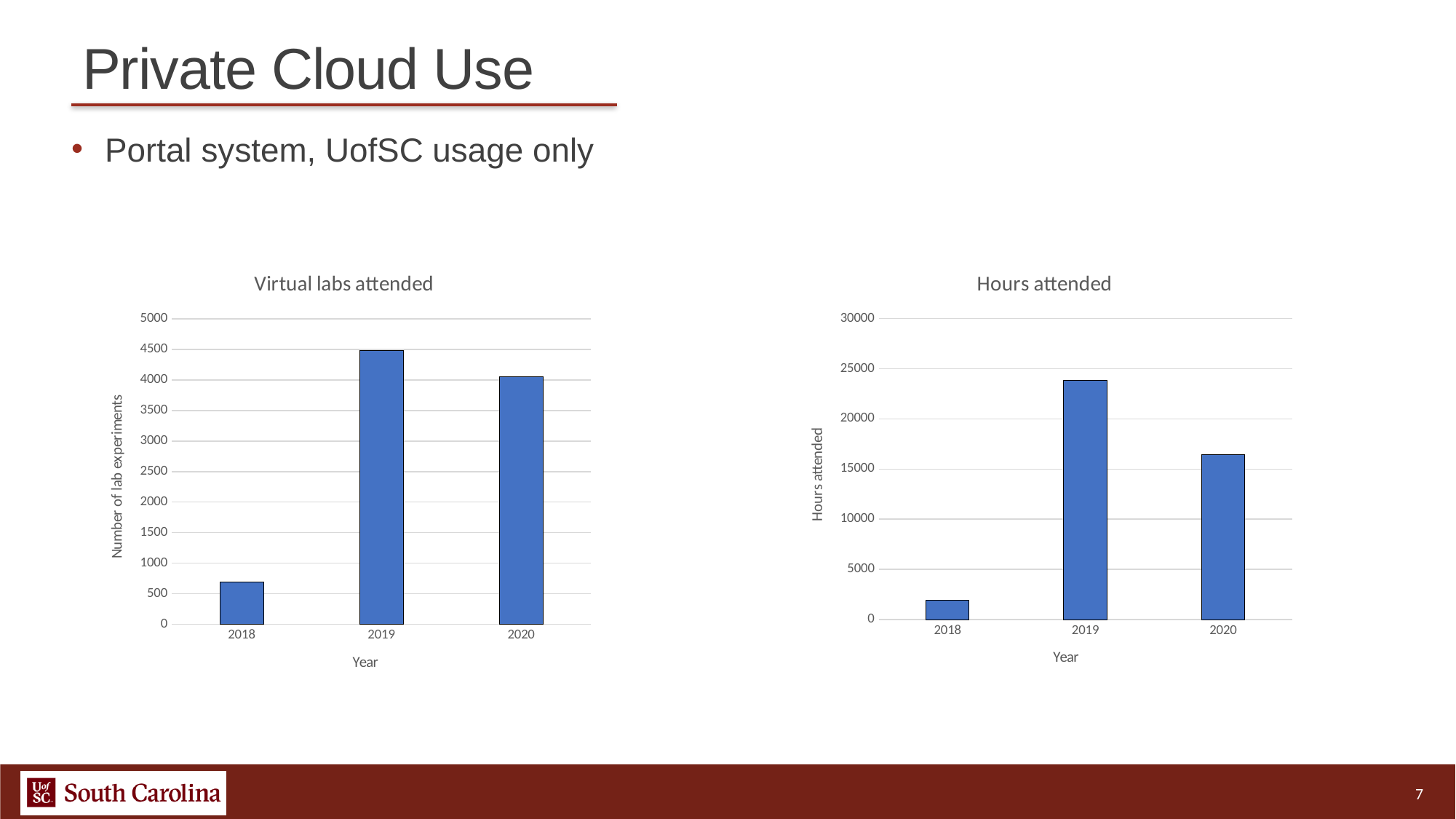
In the 'Virtual labs attended' chart, what is the label on the y axis? Number of lab experiments In the 'Hours attended' chart, does the value rise or fall from 2019 to 2020? fall In the 'Hours attended' chart, which year has the highest value? 2019 In the 'Virtual labs attended' chart, is the value for 2018 greater or less than 1000? less In the 'Virtual labs attended' chart, which year has the highest value? 2019 In the 'Virtual labs attended' chart, which year has the lowest value? 2018 In the 'Virtual labs attended' chart, how many years are plotted on the x axis? 3 In the 'Hours attended' chart, is the value for 2020 greater or less than 15000? greater In the 'Virtual labs attended' chart, is the value for 2020 greater or less than 3500? greater In the 'Hours attended' chart, which year has the lowest value? 2018 In the 'Hours attended' chart, which is larger, the value for 2019 or the value for 2020? 2019 In the 'Virtual labs attended' chart, what kind of chart is shown? bar chart